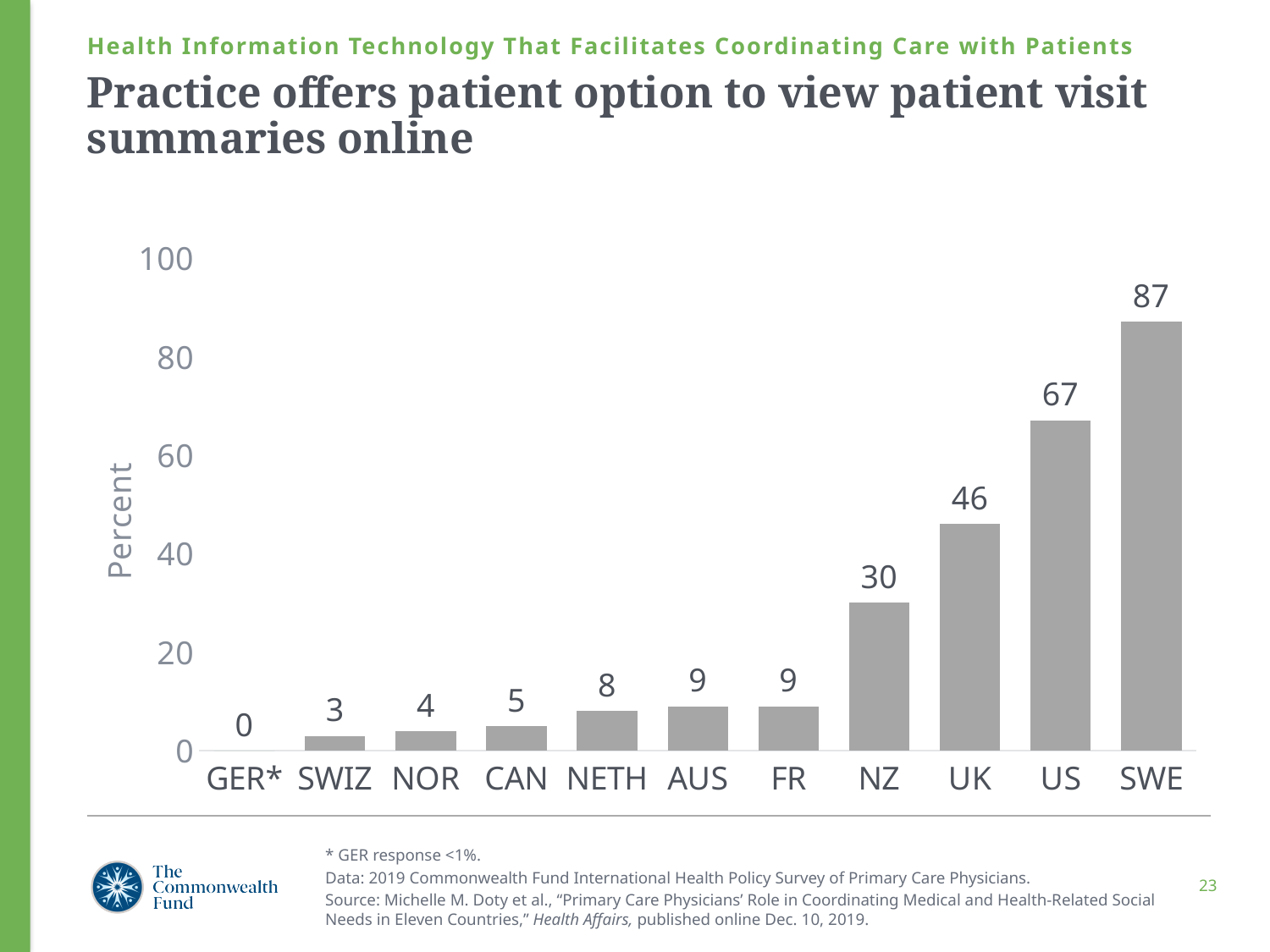
What is the value for UK? 46 Which country has the highest value? SWE Which country has the lowest value? GER* How many countries are shown on the x axis? 11 What kind of chart is this? bar chart What is the value for SWE? 87 What is the value for NETH? 8 What is the label of the y axis? Percent Which is larger, the value for CAN or the value for NOR? CAN What is the difference between the values for US and NZ? 37 Do the values rise or fall from left to right along the x axis? rise Is the value for US greater or less than 60? greater